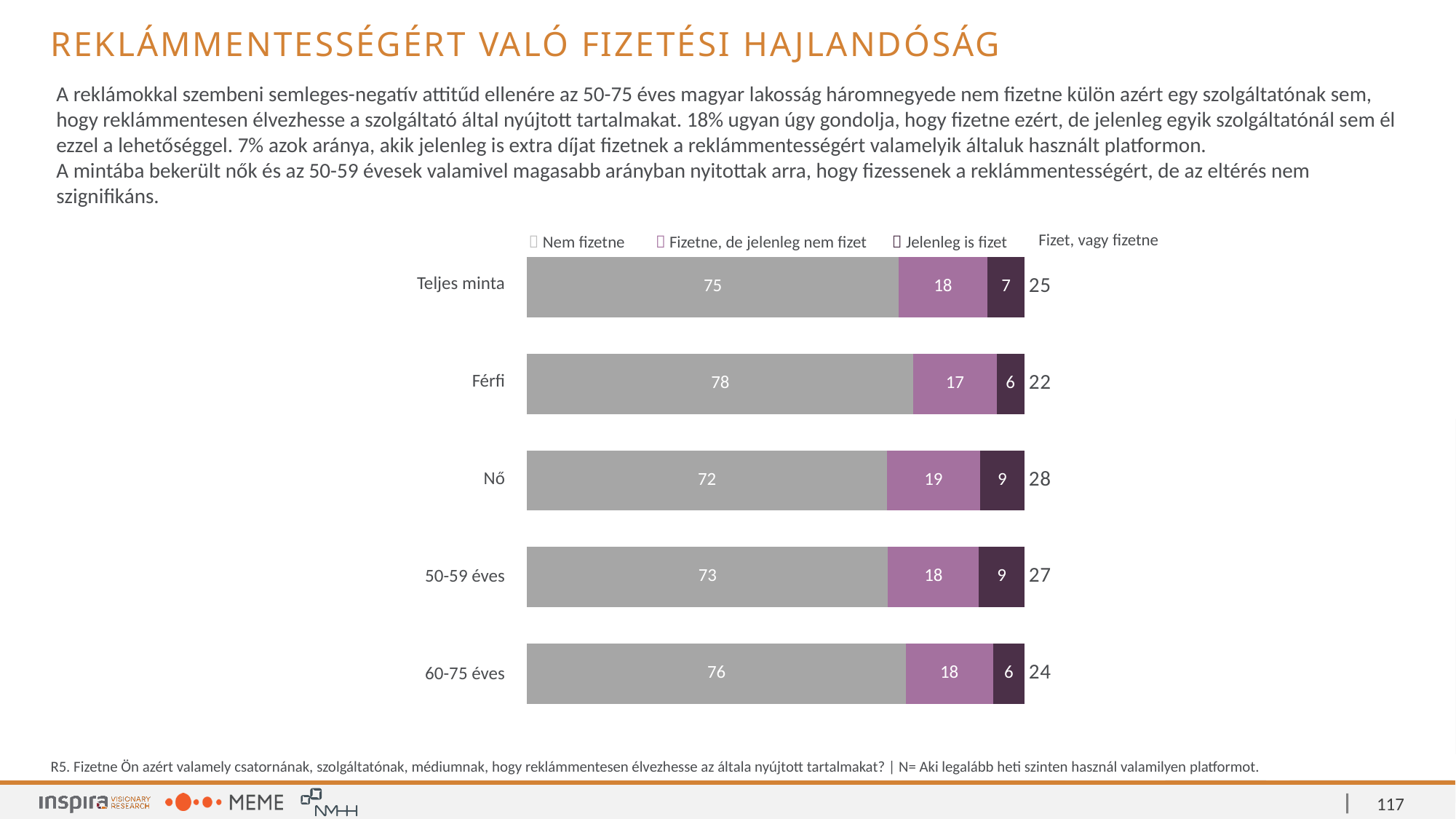
What is the value of "Fizetne, de jelenleg nem fizet" for Férfi? 17 How many series does the legend list? 3 What is the value of "Nem fizetne" for Teljes minta? 75 What kind of chart is shown on the slide? Stacked bar chart Which is larger: the "Jelenleg is fizet" value for 50-59 éves or for 60-75 éves? 50-59 éves What is the difference between the "Nem fizetne" values for Férfi and Nő? 6 How many categories are shown on the chart? 5 What is the total of the "Fizetne, de jelenleg nem fizet" and "Jelenleg is fizet" segments for Teljes minta? 25 What is the "Fizet, vagy fizetne" value shown for 50-59 éves? 27 Which category has the lowest "Nem fizetne" value? Nő What is the value of "Jelenleg is fizet" for Nő? 9 Which category has the highest "Nem fizetne" value? Férfi